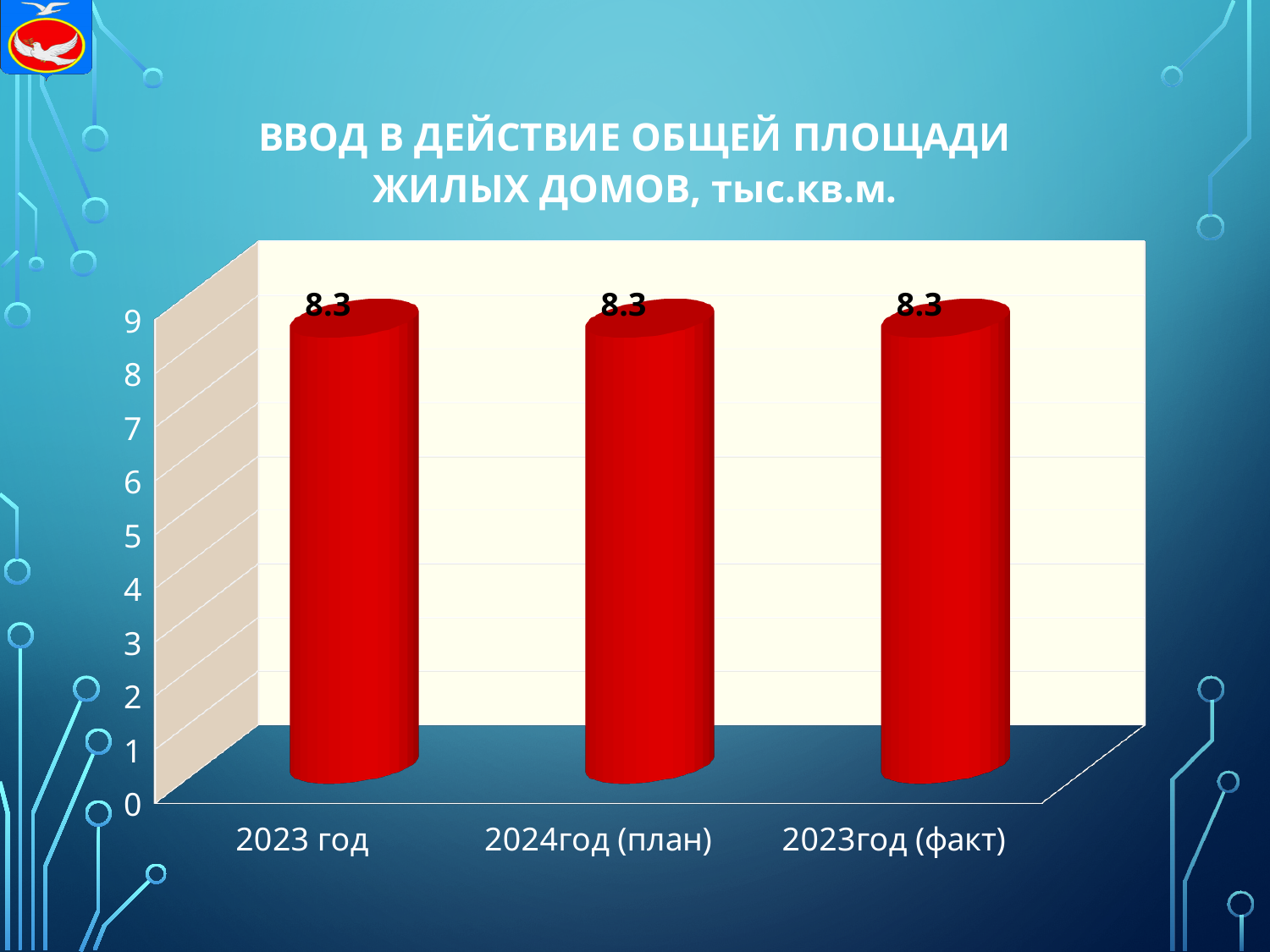
How many categories are shown on the x axis? 3 What is the value for 2023год (факт)? 8.3 What is the value for 2023 год? 8.3 What is the highest value shown on the vertical axis? 9 Do the values rise, fall or stay the same across the categories from left to right? stay the same What is the difference between the values for 2023год (факт) and 2023 год? 0 What is the difference between the values for 2024год (план) and 2023 год? 0 What kind of chart is shown on the slide? bar chart What is the title of the chart? ВВОД В ДЕЙСТВИЕ ОБЩЕЙ ПЛОЩАДИ ЖИЛЫХ ДОМОВ, тыс.кв.м. What is the value for 2024год (план)? 8.3 Is the value for 2024год (план) greater or less than 5? greater